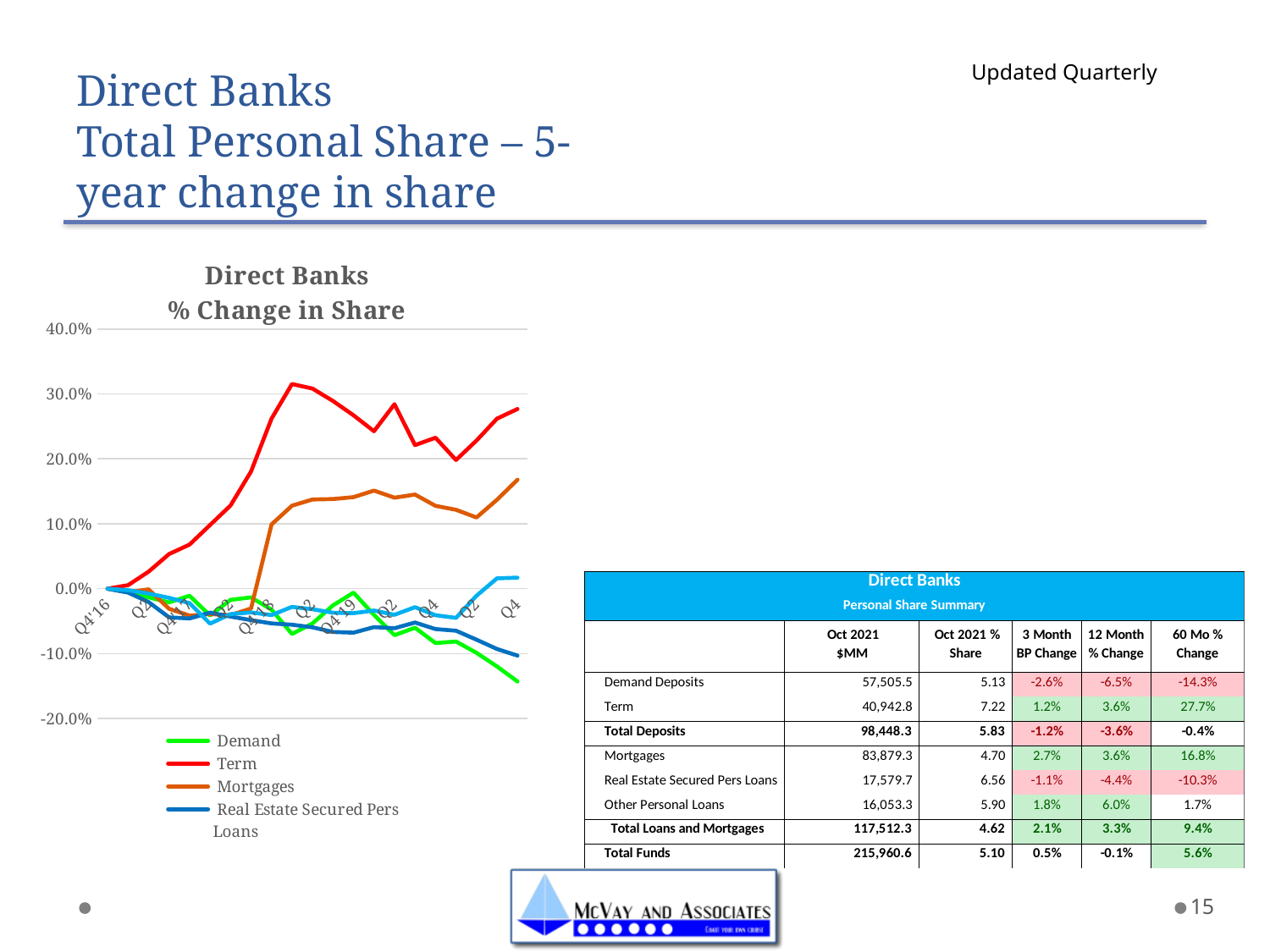
How many series does the legend of the "Direct Banks % Change in Share" chart list? 4 In the "Direct Banks % Change in Share" chart, at the final quarter, which is larger: Term or Mortgages? Term In the "Direct Banks % Change in Share" chart, is the value for Mortgages at the final quarter greater or less than 10.0%? greater What kind of chart is the "Direct Banks % Change in Share" chart? line chart In the "Direct Banks % Change in Share" chart, what colour is the line for Term? red In the "Direct Banks % Change in Share" chart, which series has the highest value at the final quarter? Term In the "Direct Banks % Change in Share" chart, is the peak value of the Term series greater or less than 20.0%? greater In the "Direct Banks % Change in Share" chart, does the Demand series overall rise or fall from Q4'16 to the final quarter? fall In the "Direct Banks % Change in Share" chart, which series has the lowest value at the final quarter? Demand In the "Direct Banks % Change in Share" chart, is the value for Term at the final quarter greater or less than 20.0%? greater In the "Direct Banks % Change in Share" chart, does the Term series overall rise or fall from Q4'16 to the final quarter? rise